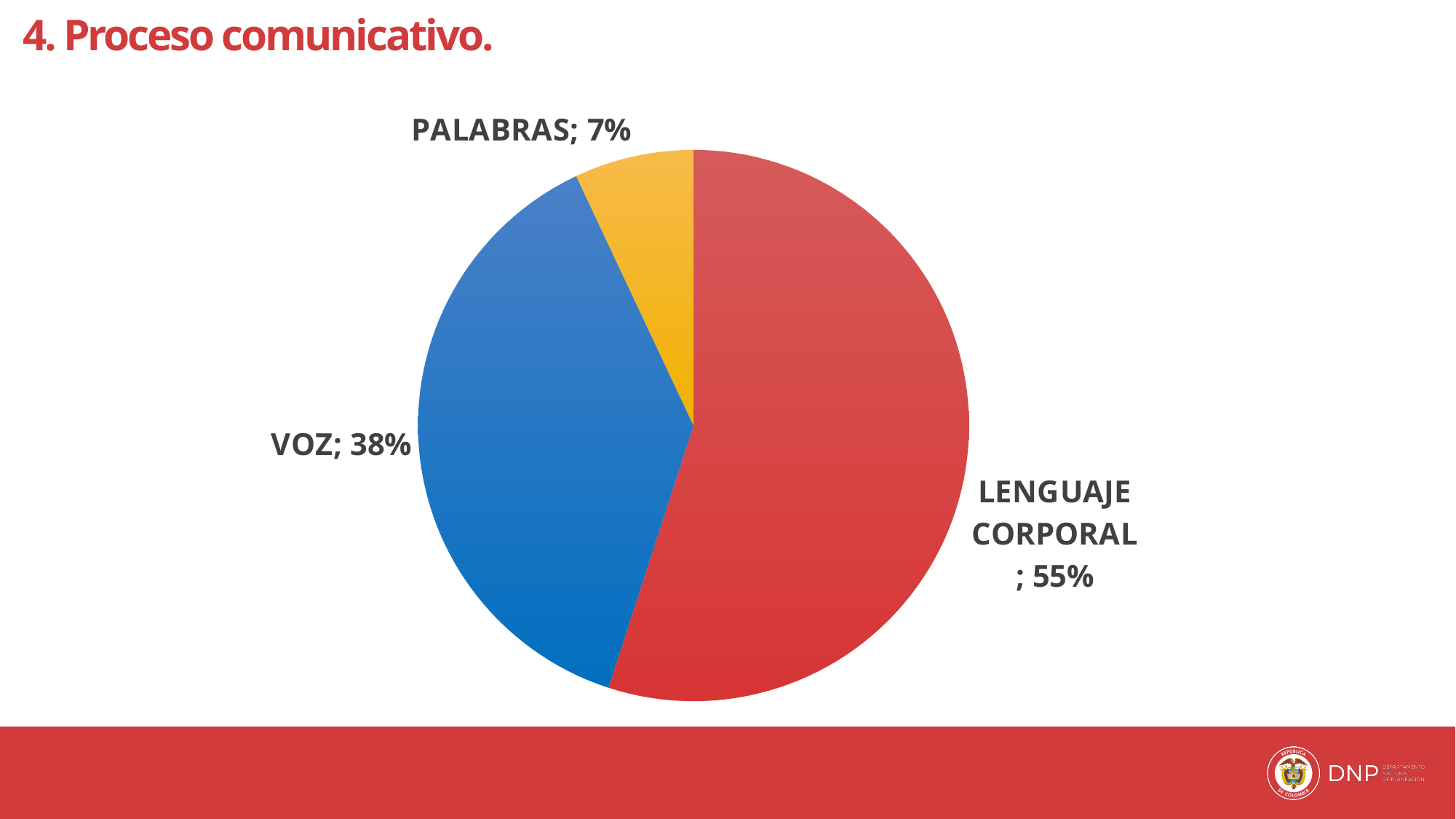
Which category has the smallest share of the pie? PALABRAS Which is larger, the share for VOZ or the share for PALABRAS? VOZ What percentage is shown for LENGUAJE CORPORAL? 55% What percentage is shown for PALABRAS? 7% What is the title of the slide containing the chart? 4. Proceso comunicativo. How many slices does the pie chart have? 3 What is the difference in percentage points between VOZ and PALABRAS? 31 What type of chart is shown on the slide? pie chart What percentage is shown for VOZ? 38% What is the difference in percentage points between LENGUAJE CORPORAL and VOZ? 17 Which category has the largest share of the pie? LENGUAJE CORPORAL What colour is the slice for VOZ? blue